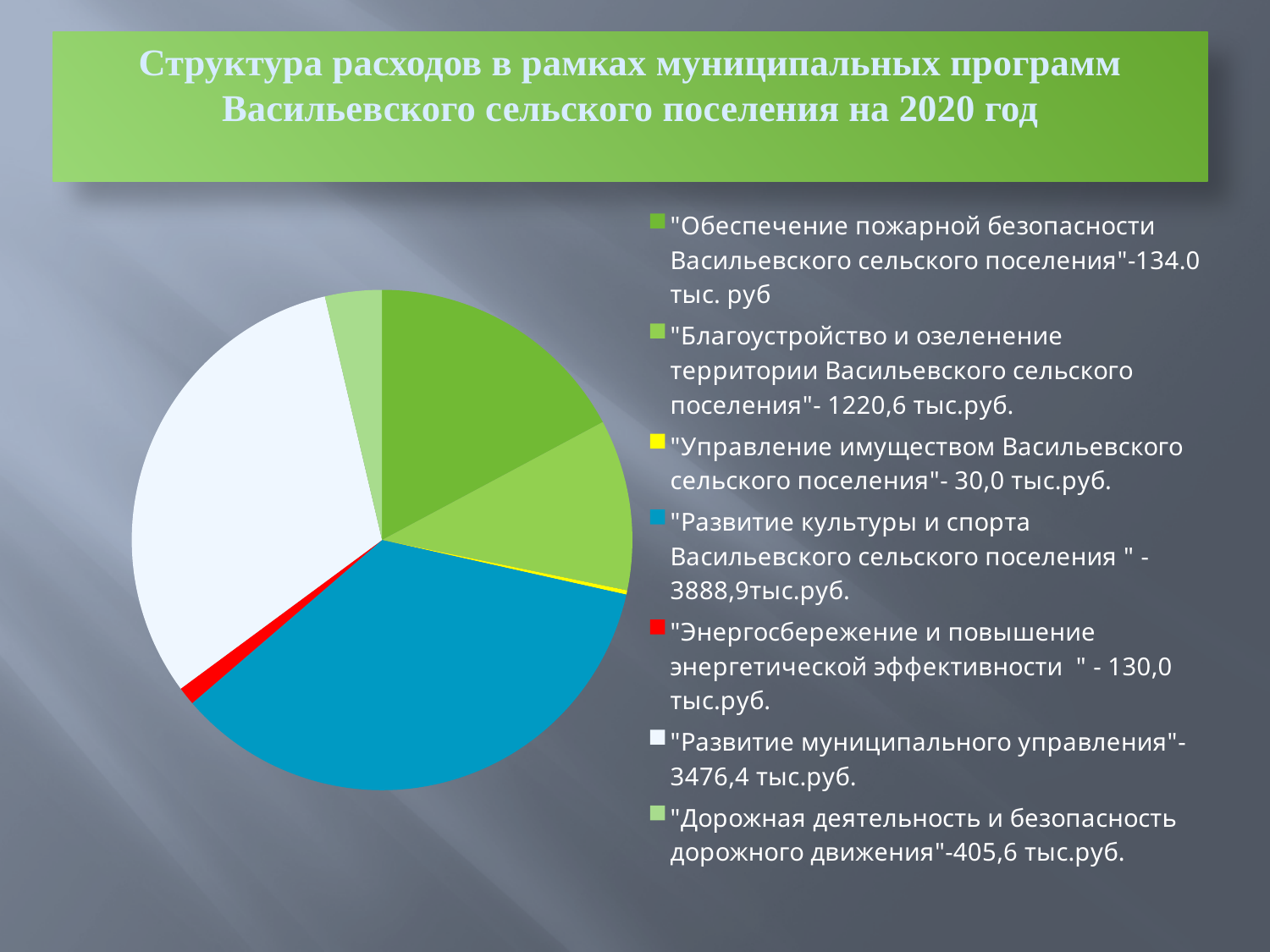
What is the value for "Развитие муниципального управления"? 3476,4 тыс.руб. What is the value for "Дорожная деятельность и безопасность дорожного движения"? 405,6 тыс.руб. Which is larger: "Благоустройство и озеленение территории" or "Дорожная деятельность и безопасность дорожного движения"? "Благоустройство и озеленение территории" How many categories does the pie chart have? 7 What is the value for "Развитие культуры и спорта Васильевского сельского поселения"? 3888,9 тыс.руб. What colour is the slice for "Энергосбережение и повышение энергетической эффективности"? red What kind of chart is shown on the slide? pie chart Which category has the smallest share of the pie? "Управление имуществом Васильевского сельского поселения" What is the value for "Управление имуществом Васильевского сельского поселения"? 30,0 тыс.руб. Which category has the largest share of the pie? "Развитие культуры и спорта Васильевского сельского поселения" What is the difference between "Развитие культуры и спорта" and "Развитие муниципального управления"? 412,5 тыс.руб. What is the title of the slide? Структура расходов в рамках муниципальных программ Васильевского сельского поселения на 2020 год